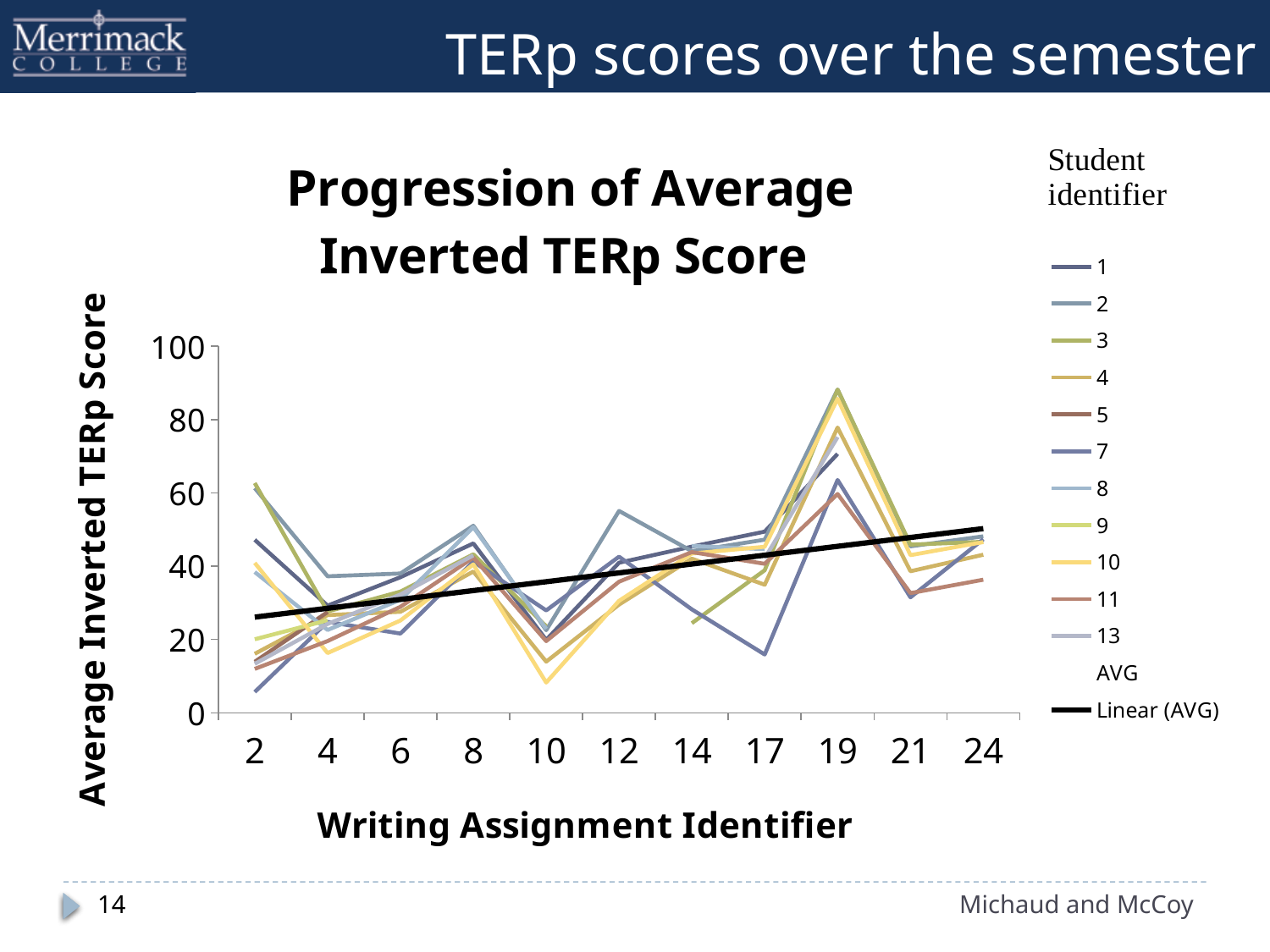
Is the highest plotted value at writing assignment 19 greater or less than 80? greater What is the maximum value shown on the y axis? 100 Is the value of the Linear (AVG) line at writing assignment 24 greater or less than 40? greater Is the value of the Linear (AVG) line at writing assignment 2 greater or less than 40? less What kind of chart is shown on the slide? Line chart How many entries does the legend list? 13 Does the Linear (AVG) trend line rise or fall from left to right across the writing assignments? Rises What is the title of the chart's legend? Student identifier What is the title of the chart? Progression of Average Inverted TERp Score At which writing assignment identifier do the student lines reach their highest peak? 19 How many writing assignment identifiers are shown along the x axis? 11